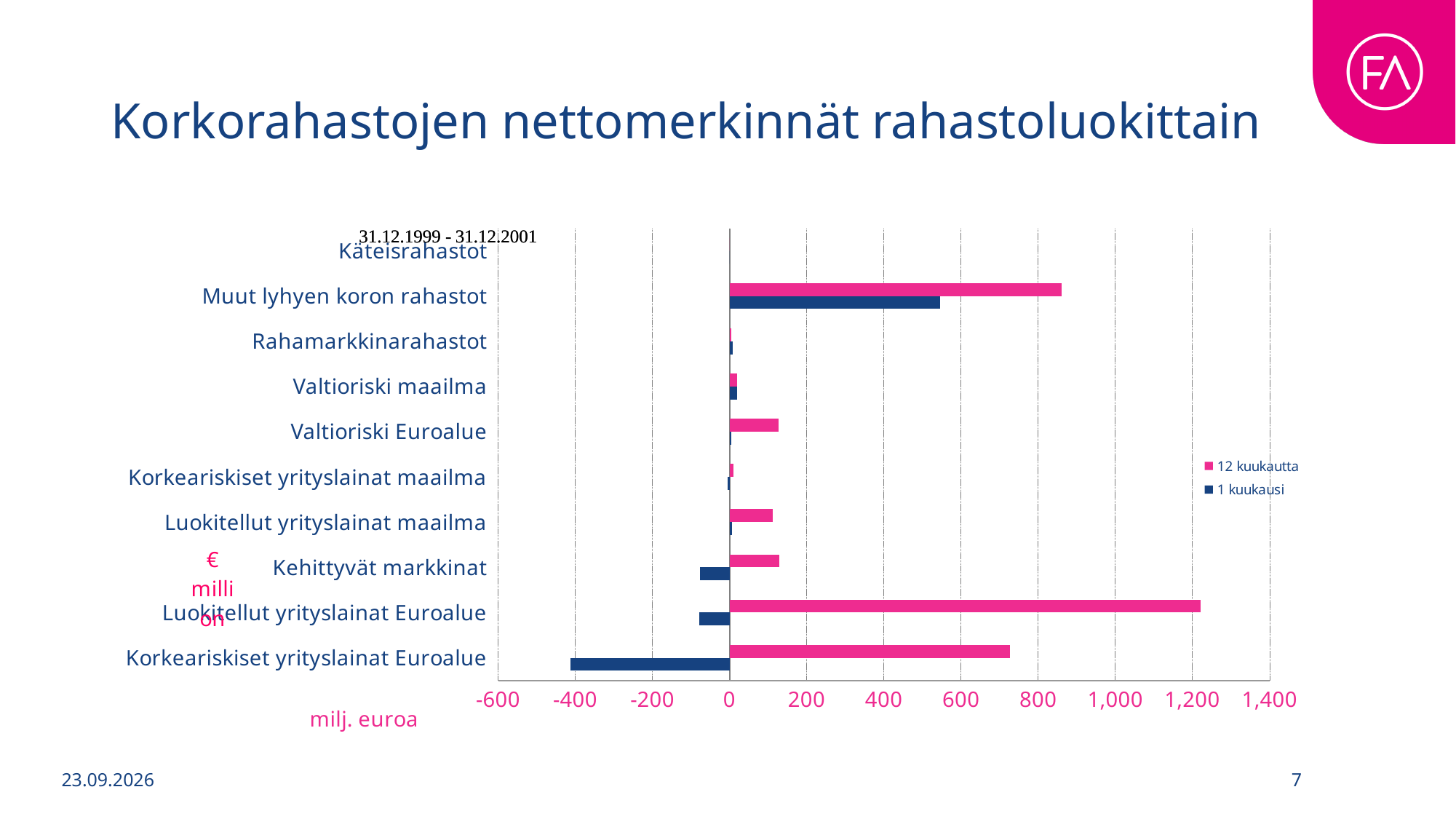
Is the 1 kuukausi value for Korkeariskiset yrityslainat Euroalue greater or less than -200? less Is the 12 kuukautta value for Korkeariskiset yrityslainat Euroalue greater or less than 600? greater Is the 1 kuukausi value for Muut lyhyen koron rahastot greater or less than 400? greater For the 12 kuukautta series, which is larger: Muut lyhyen koron rahastot or Korkeariskiset yrityslainat Euroalue? Muut lyhyen koron rahastot What kind of chart is shown on the slide? bar chart How many fund categories are listed on the vertical axis? 10 Which category has the highest value for the 12 kuukautta series? Luokitellut yrityslainat Euroalue What unit is shown on the horizontal axis of the chart? milj. euroa How many series does the legend list? 2 Which category has the lowest (most negative) value for the 1 kuukausi series? Korkeariskiset yrityslainat Euroalue Which category has the highest value for the 1 kuukausi series? Muut lyhyen koron rahastot